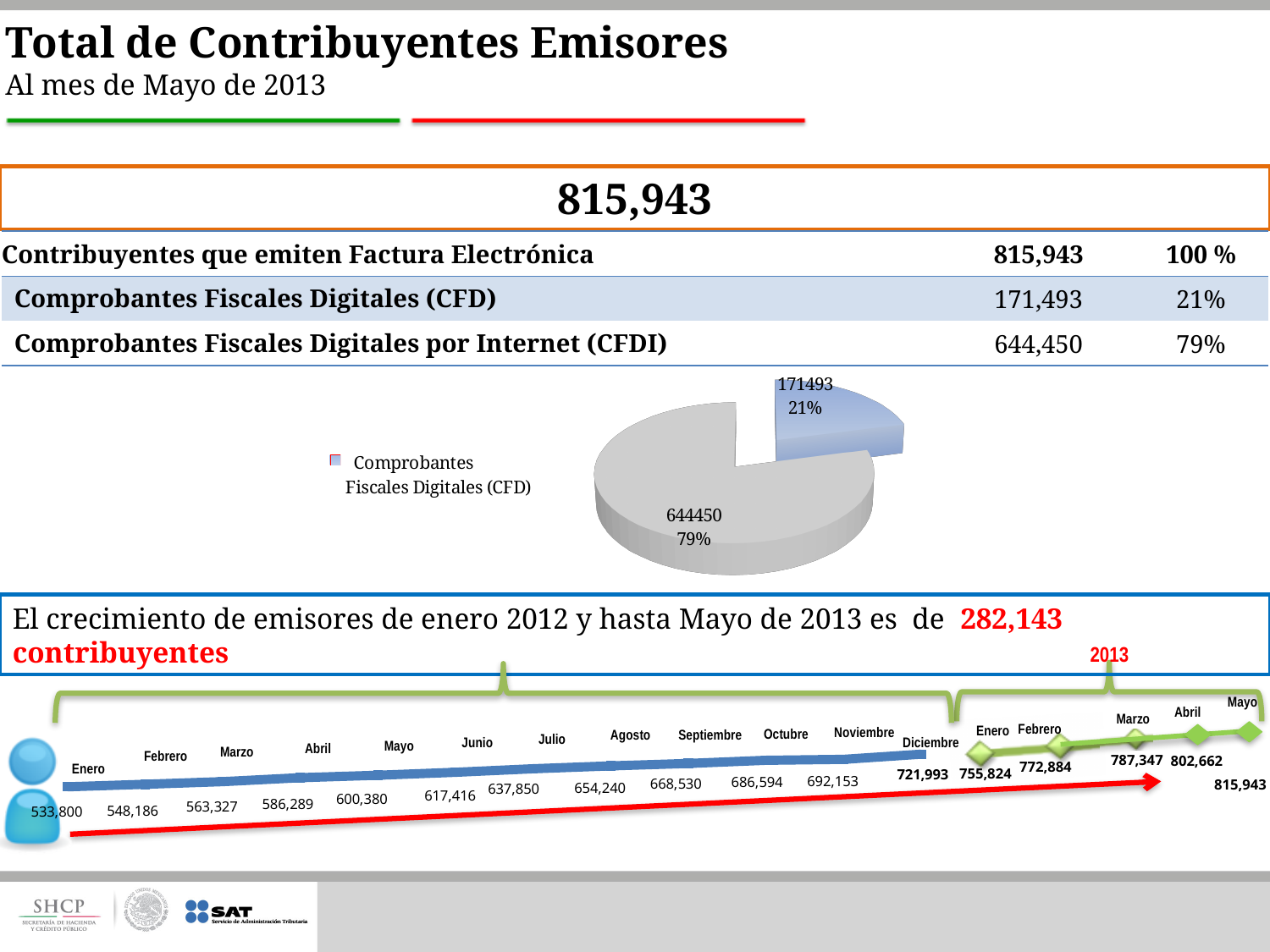
In the timeline chart at the bottom of the slide, what is the value for Mayo 2013? 815,943 In the timeline chart at the bottom of the slide, what is the value for Enero 2012? 533,800 In the timeline chart at the bottom of the slide, which month has the highest value? Mayo 2013 In the timeline chart at the bottom of the slide, which month has the lowest value? Enero 2012 In the timeline chart at the bottom of the slide, do the values rise or fall from Enero 2012 to Mayo 2013? rise In the timeline chart at the bottom of the slide, what is the difference between the values for Enero 2013 and Diciembre 2012? 33,831 What kind of chart is the chart in the middle of the slide showing 21% and 79%? pie chart In the timeline chart at the bottom of the slide, what is the value for Diciembre 2012? 721,993 In the pie chart, how many slices are there? 2 In the pie chart, what share of the pie does the Comprobantes Fiscales Digitales (CFD) slice represent? 21% In the pie chart, what value is printed on the Comprobantes Fiscales Digitales (CFD) slice? 171493 In the pie chart, what value is printed on the larger slice? 644450